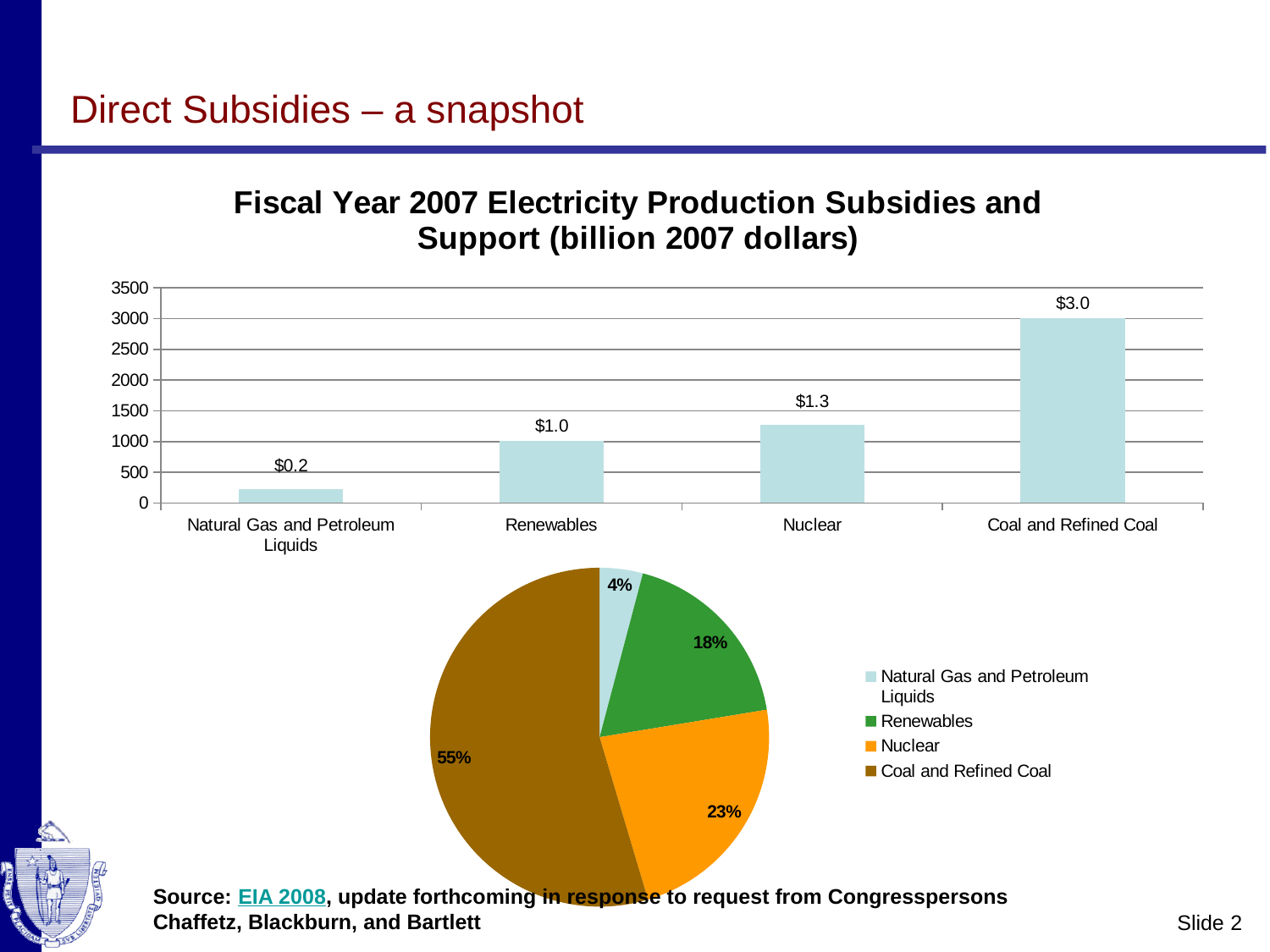
In the pie chart, what share does Nuclear have? 23% What kind of chart is the top chart on the slide? Bar chart In the bar chart, which category has the highest value? Coal and Refined Coal In the bar chart, what is the value for Coal and Refined Coal? $3.0 In the bar chart, what is the value for Renewables? $1.0 In the pie chart, which slice is the smallest? Natural Gas and Petroleum Liquids In the bar chart, what is the difference between the values for Coal and Refined Coal and Nuclear? $1.7 In the bar chart, how many categories are shown? 4 In the bar chart, what is the value for Natural Gas and Petroleum Liquids? $0.2 In the bar chart, which category has the lowest value? Natural Gas and Petroleum Liquids In the pie chart, what share does Coal and Refined Coal have? 55% In the bar chart, which is larger, the value for Nuclear or the value for Renewables? Nuclear